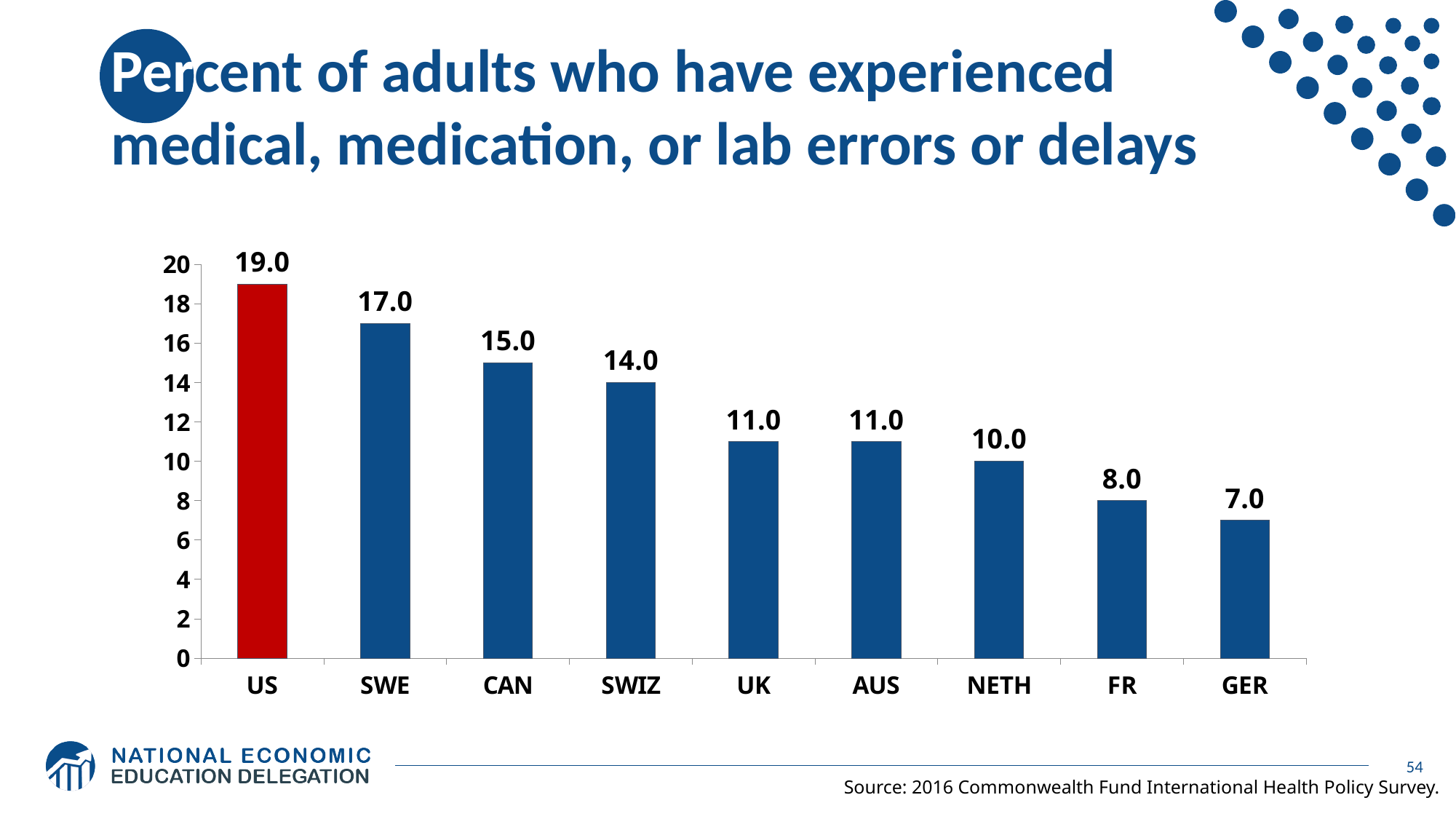
What is the value for SWIZ? 14.0 How many countries are shown on the chart? 9 What is the value for the US? 19.0 Which country's bar is coloured red? US Which country has the lowest value? GER Do the values rise or fall from left to right along the x axis? fall What is the difference between the values for the US and SWE? 2.0 What is the difference between the values for CAN and GER? 8.0 Which is larger, the value for FR or the value for NETH? NETH What kind of chart is shown on the slide? bar chart Which country has the highest value? US What is the value for NETH? 10.0